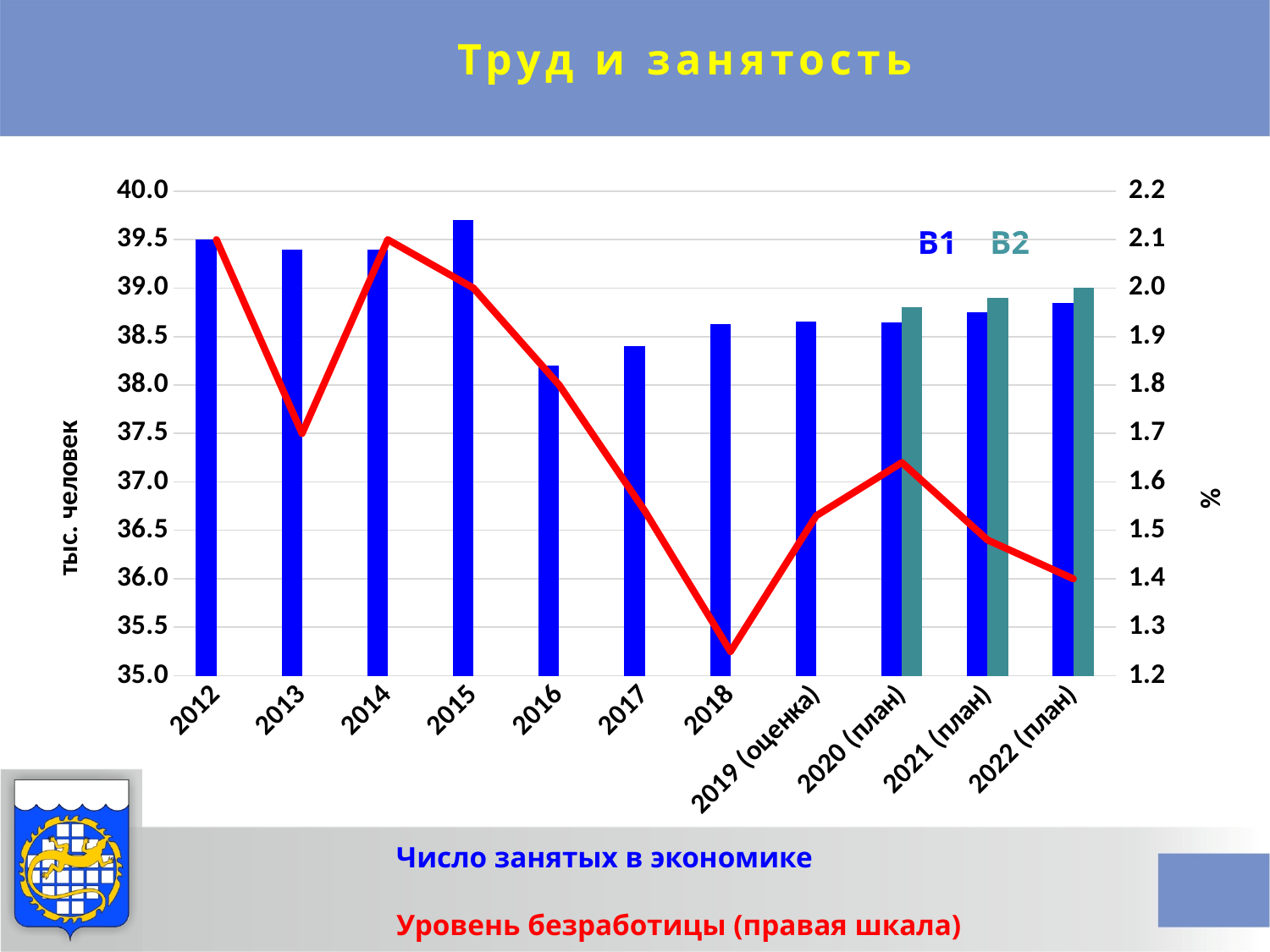
Which is larger, the Число занятых в экономике bar for 2015 or for 2016? 2015 Is the value of Уровень безработицы for 2013 greater or less than 1.8? less Is the value of Число занятых в экономике for 2016 greater or less than 38.5? less Which year has the highest value for Число занятых в экономике (the blue bars)? 2015 Is the value of Уровень безработицы for 2012 greater or less than 2.0? greater How many years (categories) are shown on the x axis? 11 Which year has the lowest value for Число занятых в экономике (the blue bars)? 2016 Which is larger, the Уровень безработицы value for 2012 or for 2013? 2012 In which year is Уровень безработицы (the red line) at its lowest? 2018 Does Уровень безработицы (the red line) rise or fall from 2014 to 2018? fall What unit is shown on the left vertical axis? тыс. человек